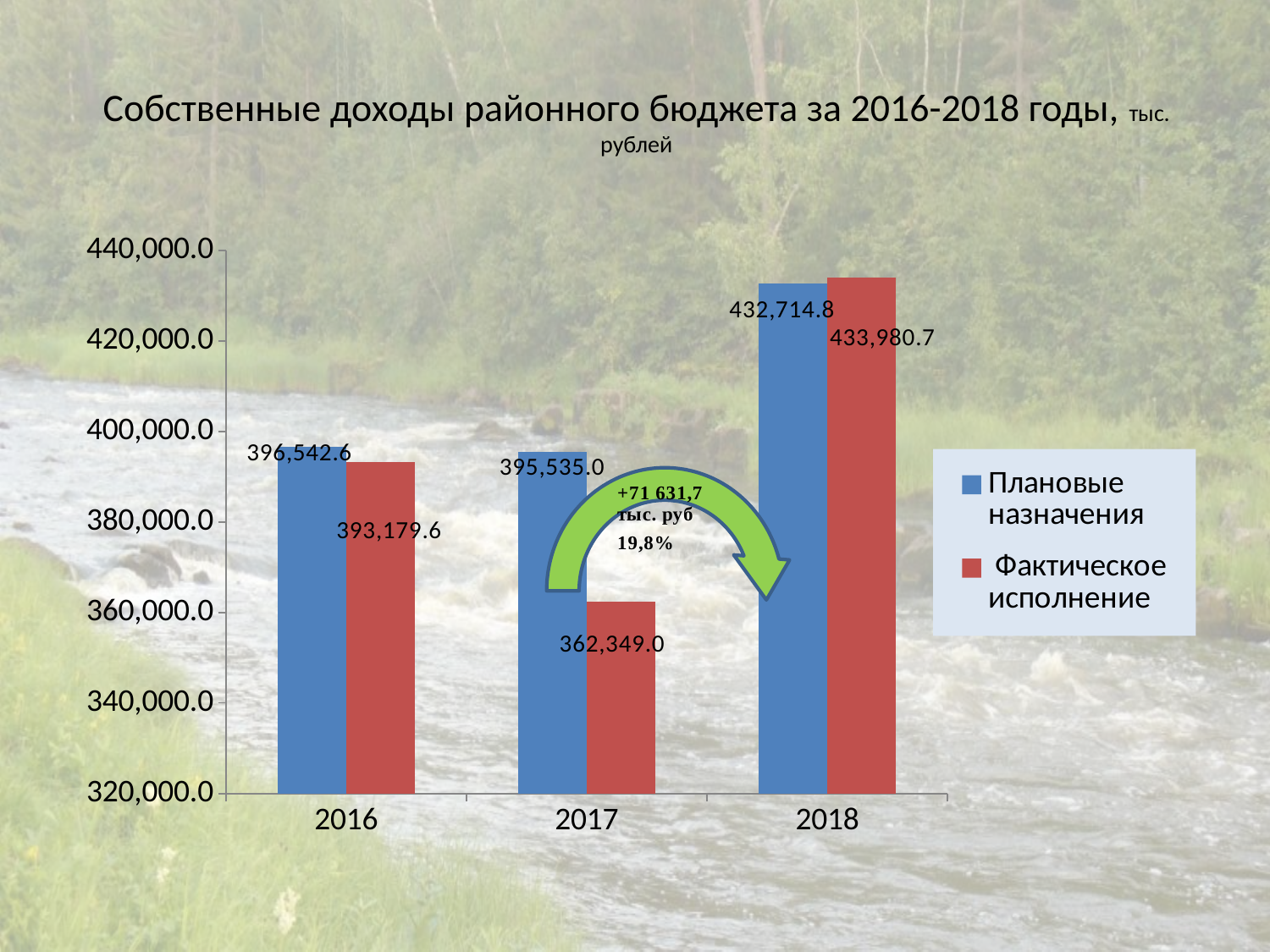
What is the value of Плановые назначения for 2018? 432,714.8 How many years are shown on the x axis? 3 In which year is Фактическое исполнение the lowest? 2017 Which is larger in 2016: Плановые назначения or Фактическое исполнение? Плановые назначения By how much did Фактическое исполнение increase from 2017 to 2018? 71,631.7 What is the value of Плановые назначения for 2016? 396,542.6 What is the difference between Плановые назначения and Фактическое исполнение in 2017? 33,186.0 How many series does the legend list? 2 What is the value of Фактическое исполнение for 2018? 433,980.7 What type of chart is shown on the slide? bar chart In which year is Плановые назначения the highest? 2018 What is the value of Фактическое исполнение for 2017? 362,349.0